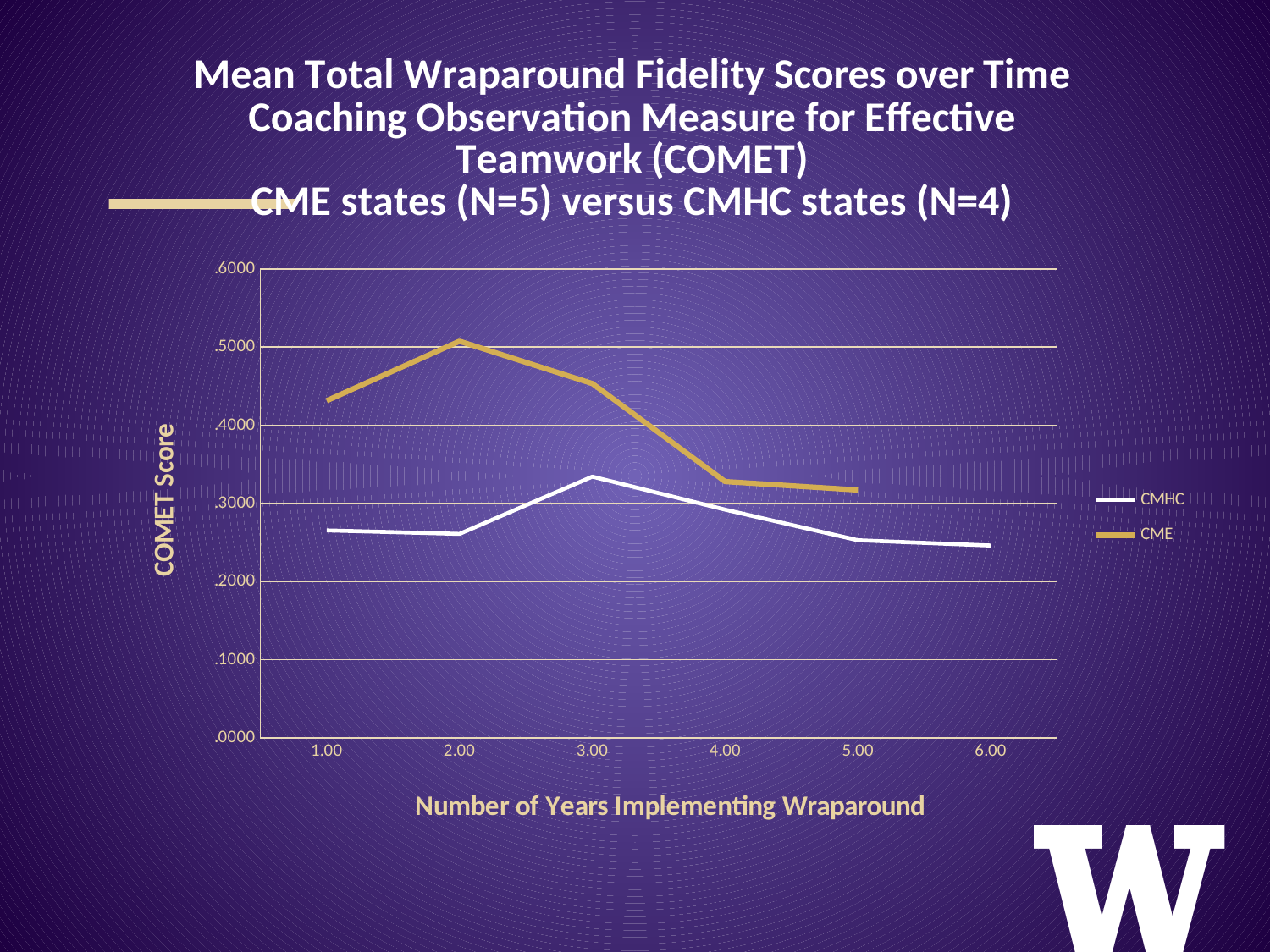
How many x-axis categories (years) are shown on the chart? 6 Does the CME series rise or fall from 2.00 years to 5.00 years? fall At which number of years does the CMHC series reach its highest value? 3.00 At which number of years does the CME series reach its highest value? 2.00 Is the CME value at 1.00 years greater or less than .4000? greater What kind of chart is shown on the slide? line chart How many series does the legend list? 2 At 3.00 years, which series has the higher COMET Score, CME or CMHC? CME Which series is drawn in gold? CME What is the label of the x axis? Number of Years Implementing Wraparound Is the CME value at 4.00 years greater or less than .4000? less Is the CMHC value at 1.00 years greater or less than .3000? less